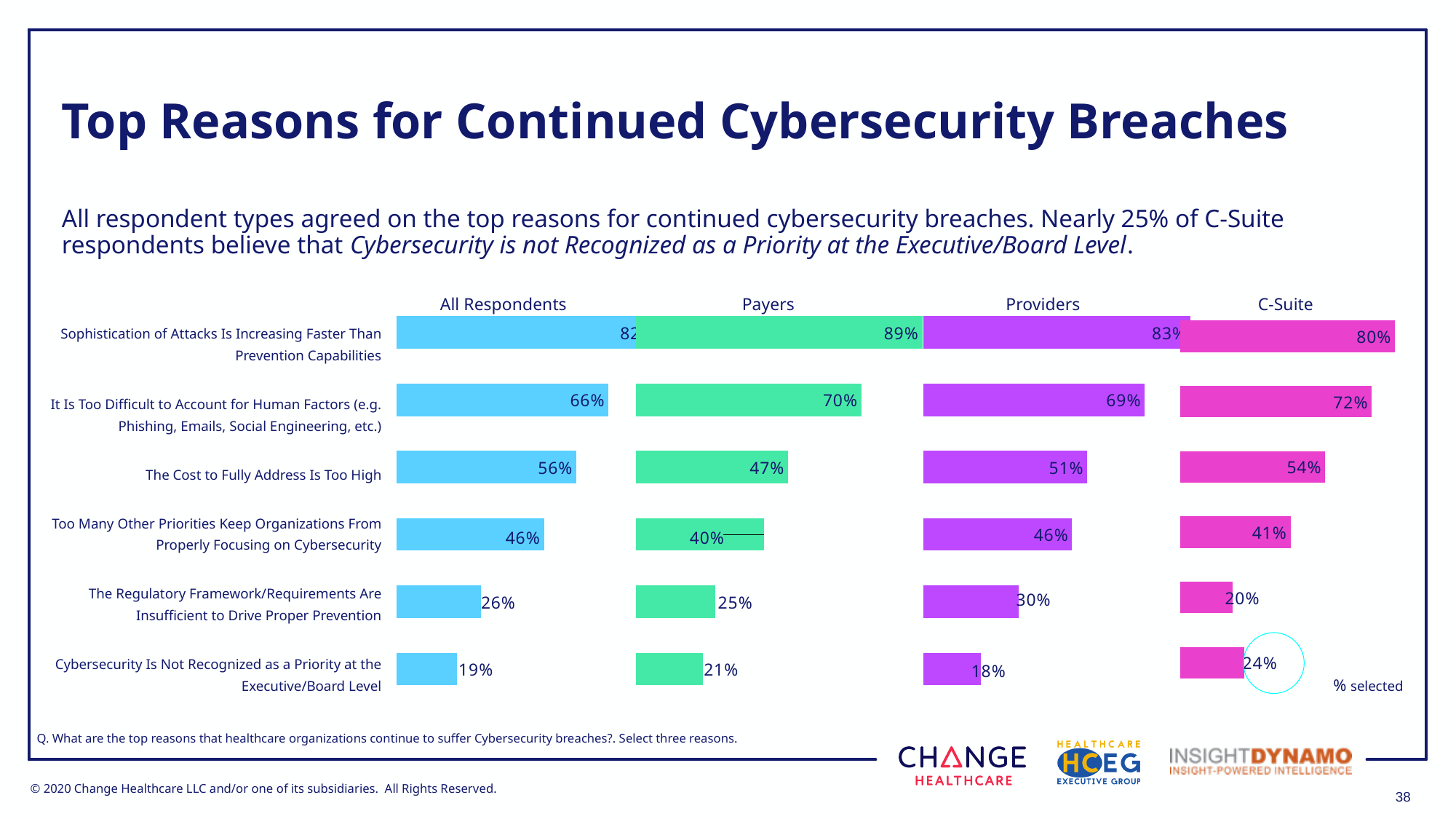
In the C-Suite chart, what percentage selected 'Cybersecurity Is Not Recognized as a Priority at the Executive/Board Level'? 24% In the Payers chart, what percentage selected 'Sophistication of Attacks Is Increasing Faster Than Prevention Capabilities'? 89% In the All Respondents chart, what is the value for 'The Cost to Fully Address Is Too High'? 56% What type of chart is used on this slide? Bar chart In the Providers chart, which reason has the lowest percentage? Cybersecurity Is Not Recognized as a Priority at the Executive/Board Level How many respondent groups are charted on the slide? 4 What colour are the bars in the Providers chart? Purple In the Providers chart, what is the value for 'The Regulatory Framework/Requirements Are Insufficient to Drive Proper Prevention'? 30% In the Payers chart, what is the difference between 'It Is Too Difficult to Account for Human Factors' and 'The Cost to Fully Address Is Too High'? 23% In the C-Suite chart, which reason has the highest percentage? Sophistication of Attacks Is Increasing Faster Than Prevention Capabilities For 'The Cost to Fully Address Is Too High', which is larger: the Payers value or the C-Suite value? C-Suite How many reasons (categories) are listed in each chart? 6